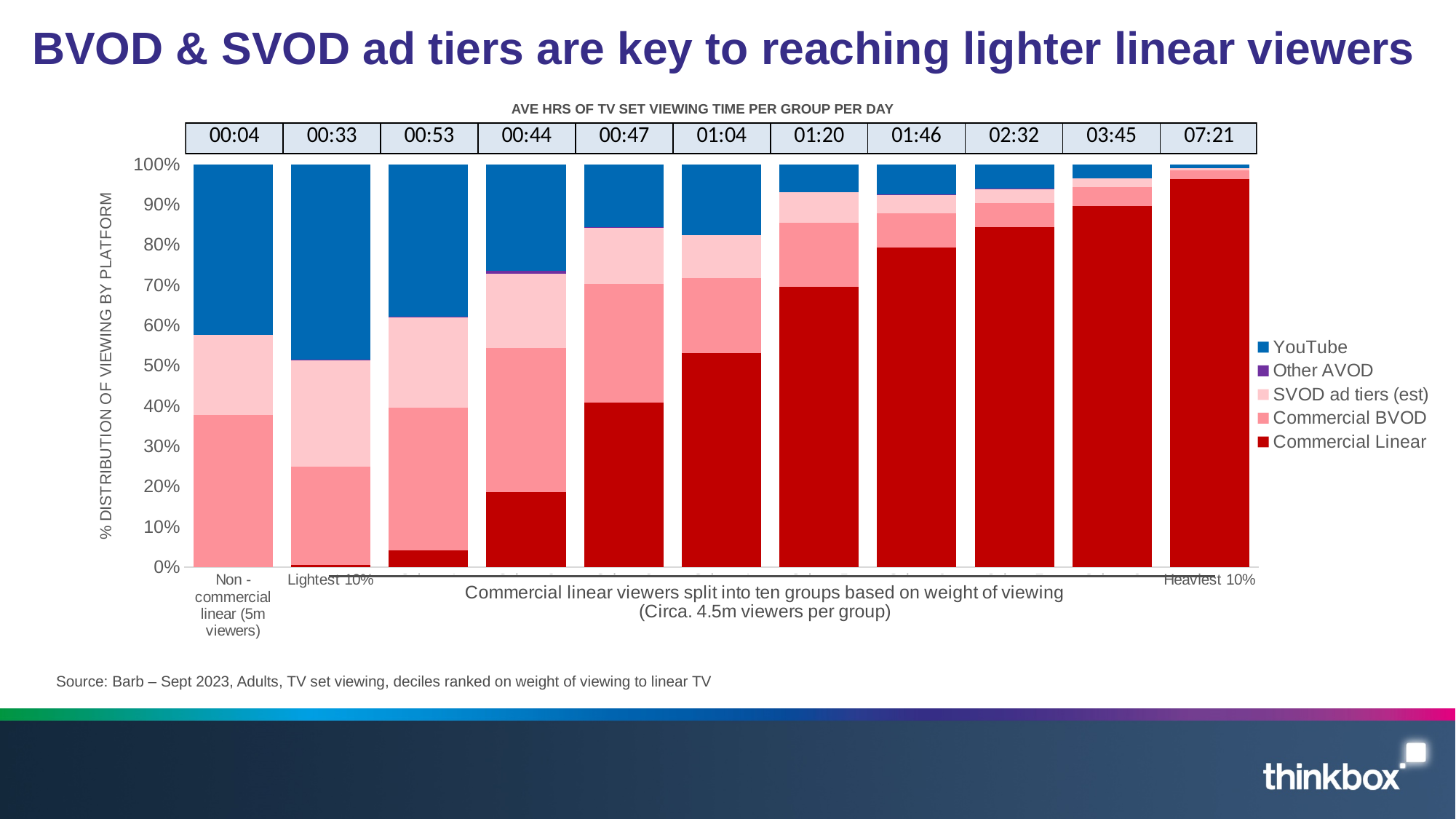
How many series does the legend list? 5 Which group has the highest average hours of TV set viewing time per day? Heaviest 10% Which series is shown in dark blue in the legend? YouTube What is the average hours of TV set viewing time per day shown for the Lightest 10% group? 00:33 What is the average hours of TV set viewing time per day shown for the Heaviest 10% group? 07:21 What kind of chart is shown on the slide? Stacked bar chart How many bars (viewer groups) are plotted in the chart? 11 Is the Commercial Linear share for the Lightest 10% group greater or less than 10%? less Is the Commercial Linear share for the Heaviest 10% group greater or less than 90%? greater Which group has the lowest average hours of TV set viewing time per day? Non-commercial linear (5m viewers) Does the Commercial Linear share rise or fall moving from the Lightest 10% group to the Heaviest 10% group? Rises What is the average hours of TV set viewing time per day shown for the Non-commercial linear group? 00:04